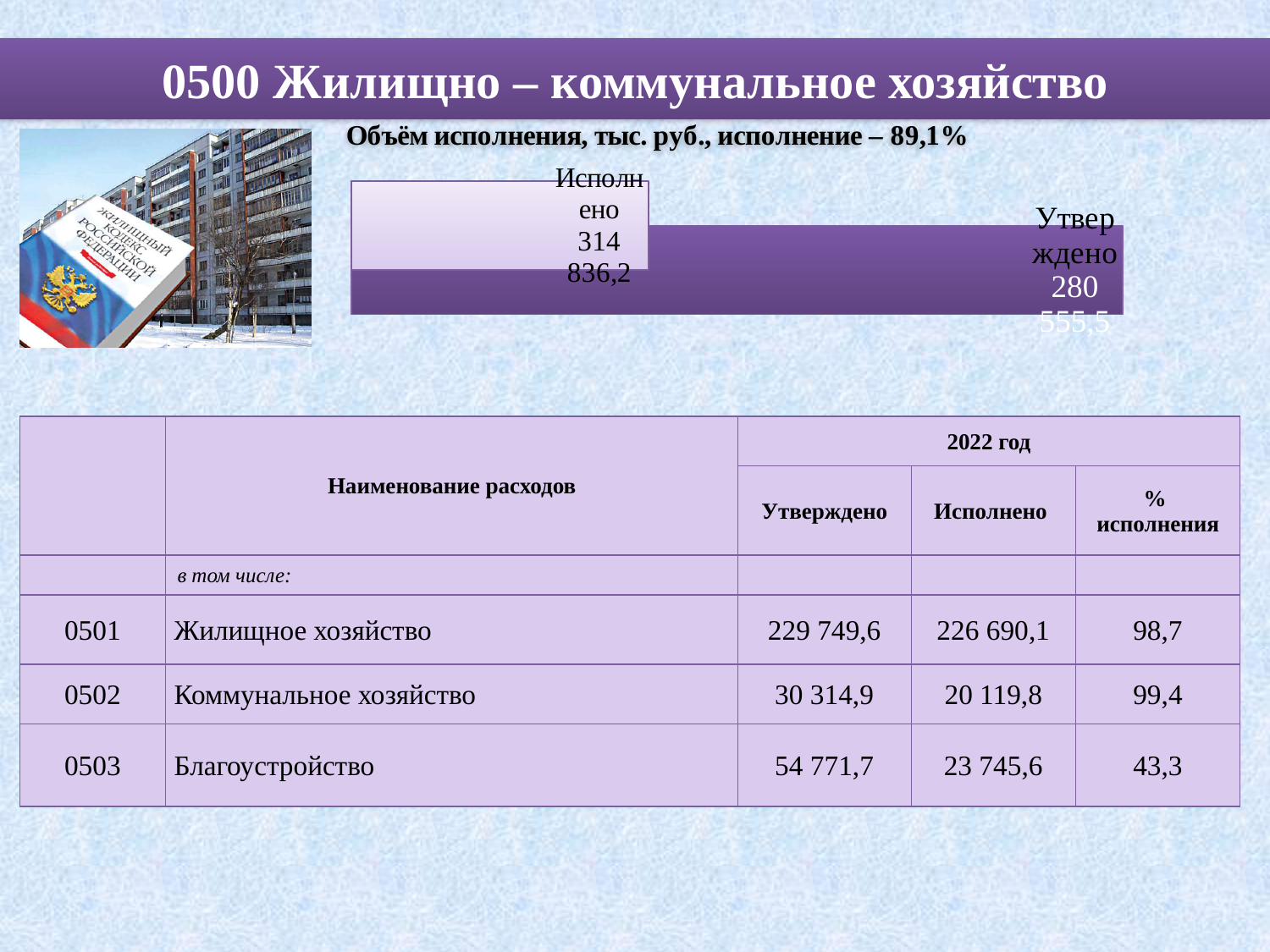
In what units are the chart values given, according to the title? тыс. руб. How many bars does the chart show? 2 What value is printed on the bar labelled "Утверждено"? 280 555,5 What value is printed on the bar labelled "Исполнено"? 314 836,2 What kind of chart is shown on the slide? bar chart What execution percentage is stated in the chart title? 89,1% What is the title of the chart? Объём исполнения, тыс. руб., исполнение – 89,1%